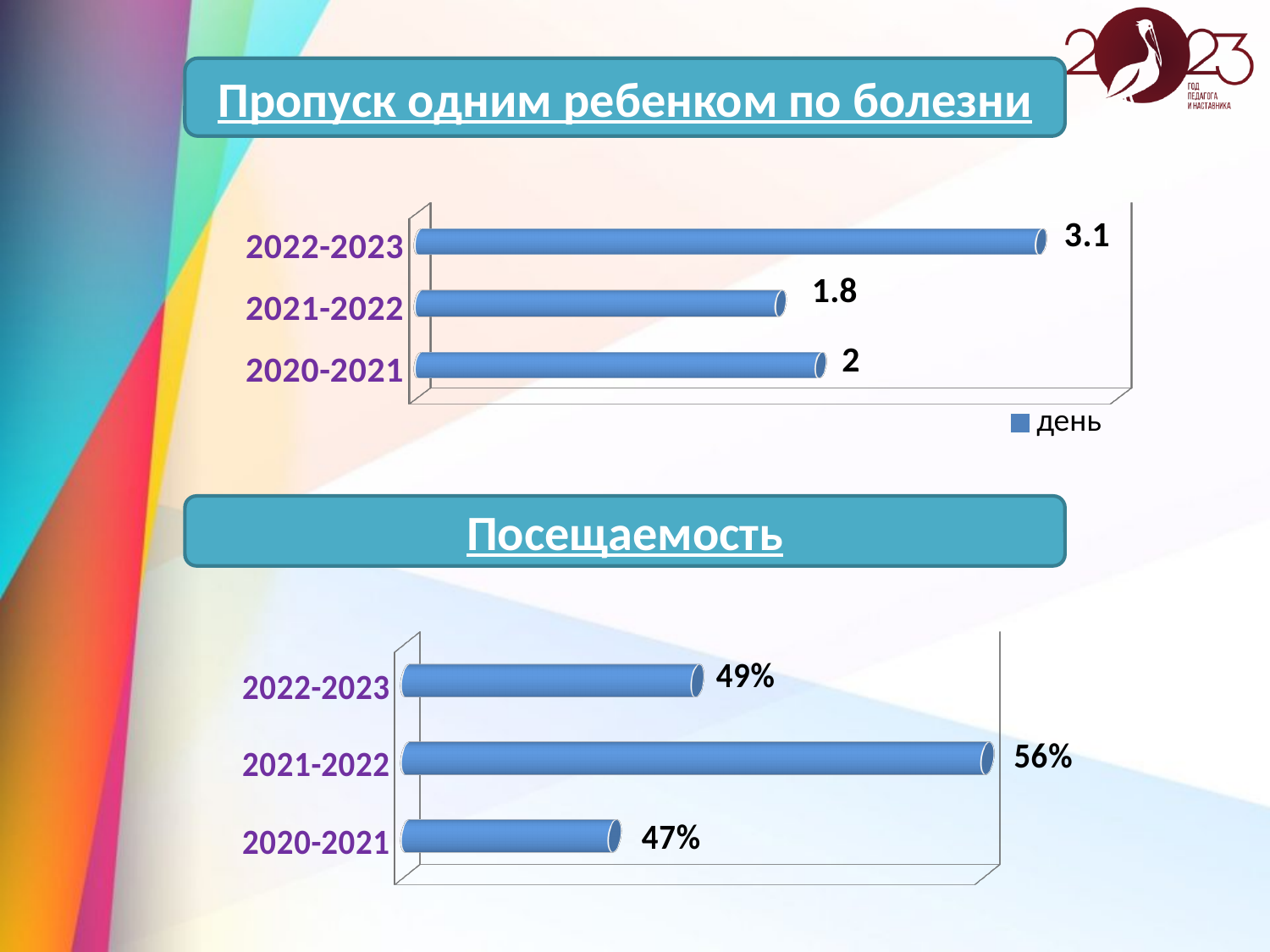
In the chart titled "Посещаемость", what is the value for 2020-2021? 47% In the chart titled "Пропуск одним ребенком по болезни", which period has the highest value? 2022-2023 In the chart titled "Пропуск одним ребенком по болезни", which period has the lowest value? 2021-2022 In the chart titled "Пропуск одним ребенком по болезни", what is the difference between the values for 2022-2023 and 2020-2021? 1.1 What type of chart is the chart titled "Посещаемость"? bar chart In the chart titled "Посещаемость", which is larger: the value for 2022-2023 or for 2020-2021? 2022-2023 In the chart titled "Посещаемость", what is the difference between the values for 2021-2022 and 2022-2023? 7% In the chart titled "Пропуск одним ребенком по болезни", what is the legend entry? день In the chart titled "Пропуск одним ребенком по болезни", what is the value for 2021-2022? 1.8 In the chart titled "Пропуск одним ребенком по болезни", what is the value for 2022-2023? 3.1 In the chart titled "Посещаемость", which period has the highest value? 2021-2022 In the chart titled "Посещаемость", what is the value for 2021-2022? 56%